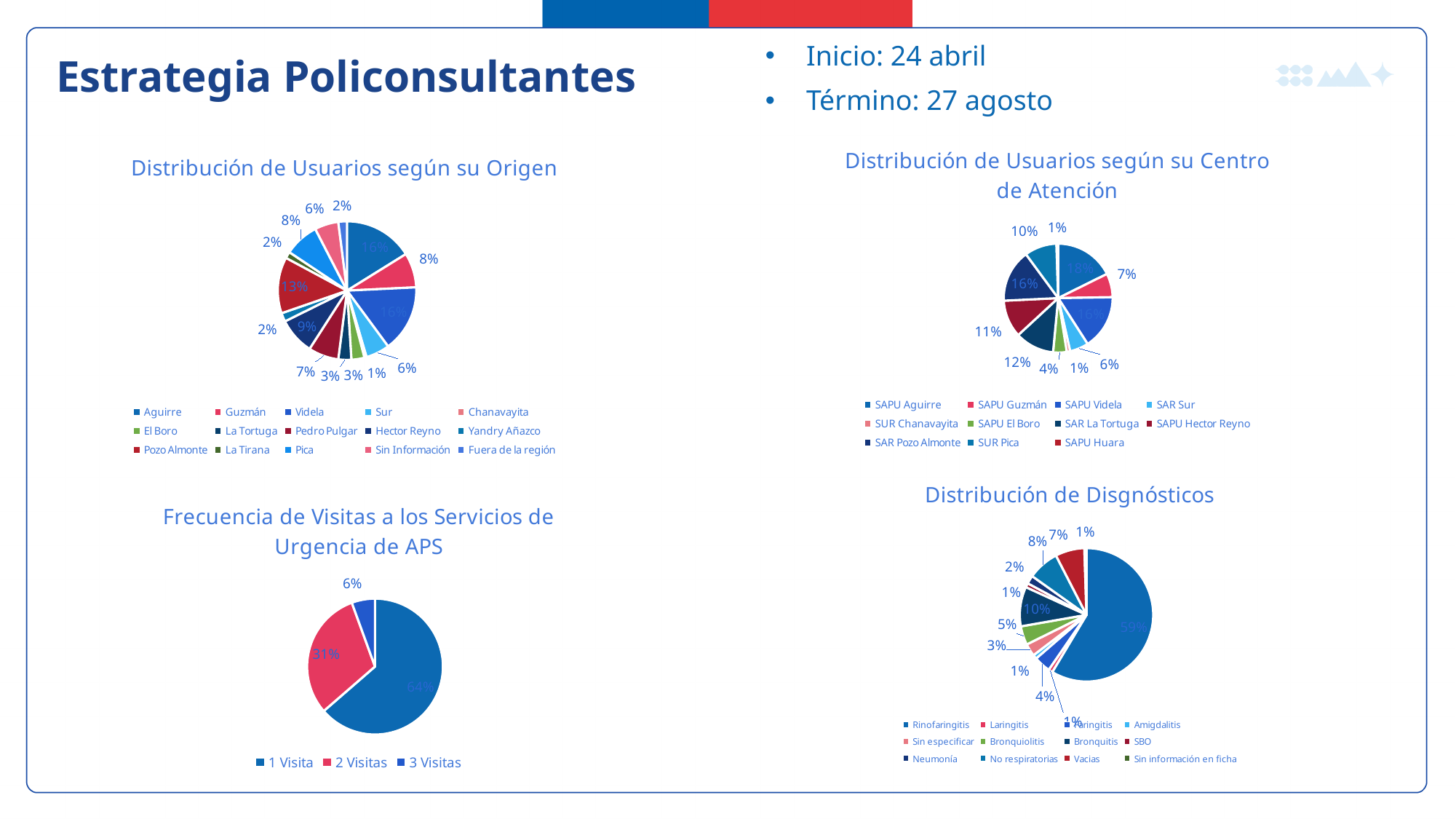
In the chart 'Frecuencia de Visitas a los Servicios de Urgencia de APS', what is the difference in percentage points between '1 Visita' and '2 Visitas'? 33 How many categories does the legend of the chart 'Distribución de Usuarios según su Origen' list? 15 In the chart 'Distribución de Disgnósticos', what is the largest share shown? 59% In the chart 'Frecuencia de Visitas a los Servicios de Urgencia de APS', what share is shown for '3 Visitas'? 6% How many categories does the legend of the chart 'Frecuencia de Visitas a los Servicios de Urgencia de APS' list? 3 In the chart 'Frecuencia de Visitas a los Servicios de Urgencia de APS', what share is shown for '2 Visitas'? 31% How many categories does the legend of the chart 'Distribución de Usuarios según su Centro de Atención' list? 11 In the chart 'Frecuencia de Visitas a los Servicios de Urgencia de APS', what share is shown for '1 Visita'? 64% In the chart 'Distribución de Disgnósticos', which category has the largest share? Rinofaringitis What type of chart is 'Distribución de Disgnósticos'? Pie chart In the chart 'Distribución de Usuarios según su Centro de Atención', what is the largest share shown? 18% In the chart 'Frecuencia de Visitas a los Servicios de Urgencia de APS', which category has the smallest share? 3 Visitas